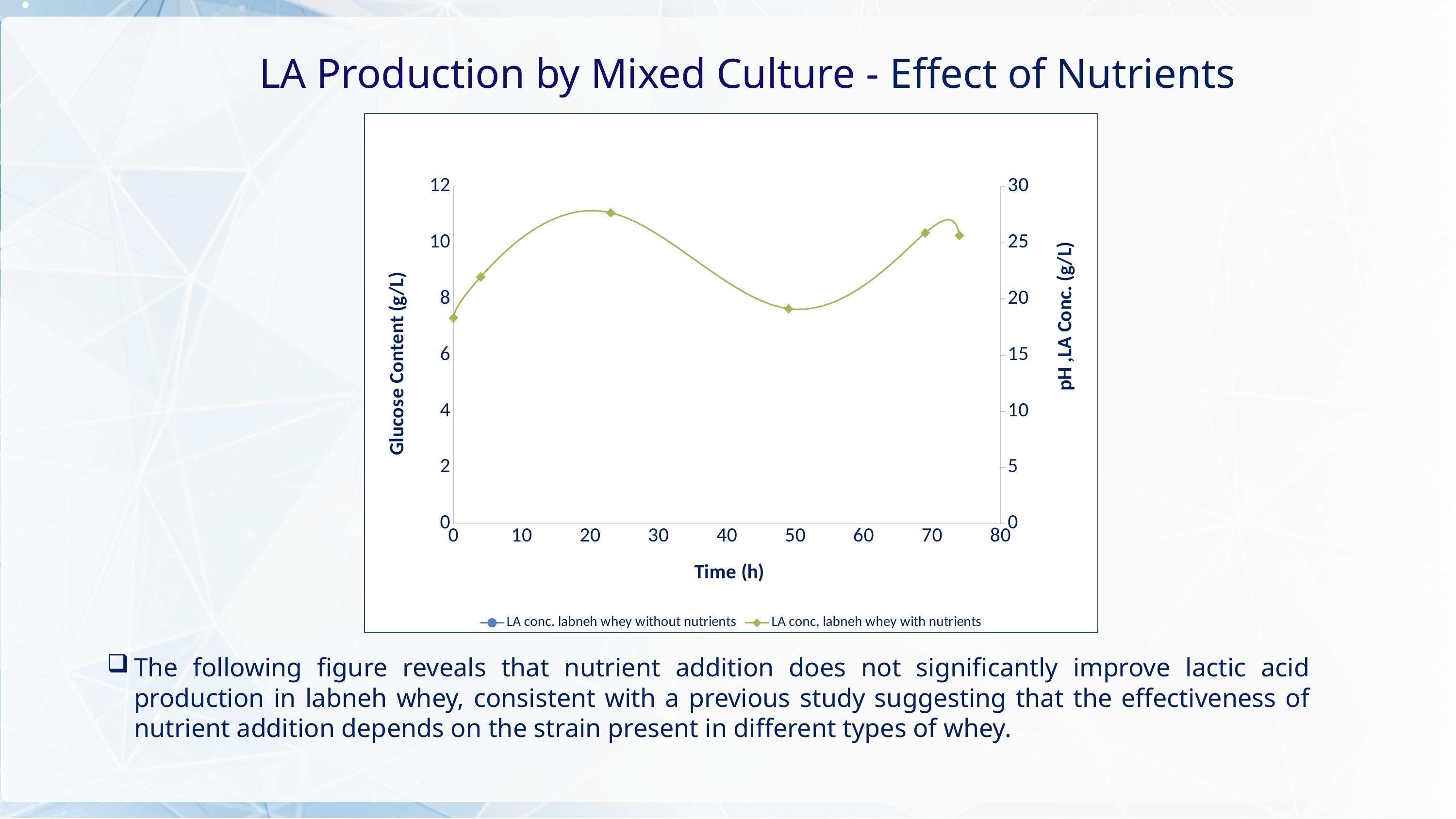
What kind of chart is shown on the slide? Line chart Read against the left-hand axis, is the green line's value at about 23 h greater or less than 10? greater Which is larger on the green line: the value at about 23 h or the value at about 49 h? The value at about 23 h Read against the left-hand axis, is the green line's value at about 49 h greater or less than 10? less Which is larger on the green line: the value at 0 h or the value at about 4 h? The value at about 4 h How many series does the chart legend list? 2 Does the green line rise or fall between about 20 h and about 50 h? Fall How many data points are plotted on the green 'LA conc, labneh whey with nutrients' line? 6 Does the green line rise or fall between 0 h and about 20 h? Rise What is the label of the left-hand y axis? Glucose Content (g/L) What is the label of the x axis? Time (h)